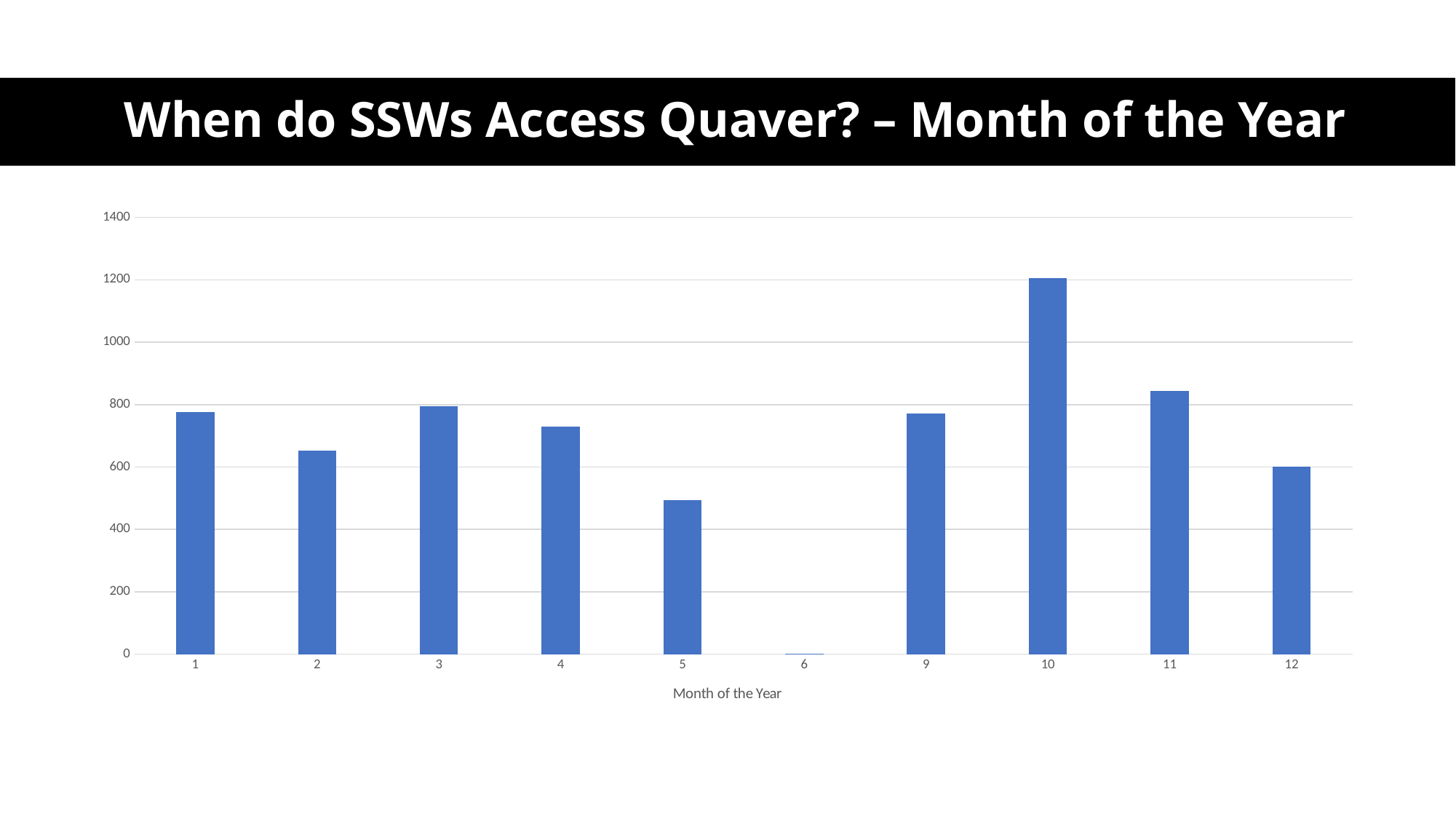
Which has the larger value, month 2 or month 5? month 2 How many months are plotted on the x axis? 10 Is the value for month 10 greater or less than 1000? greater What kind of chart is shown on the slide? bar chart Which month has the highest value? 10 What is the label on the x axis of the chart? Month of the Year Is the value for month 4 greater or less than 800? less What is the title of the chart? When do SSWs Access Quaver? – Month of the Year Do the values rise or fall from month 10 to month 12? fall Is the value for month 11 greater or less than 800? greater Which month has the lowest value? 6